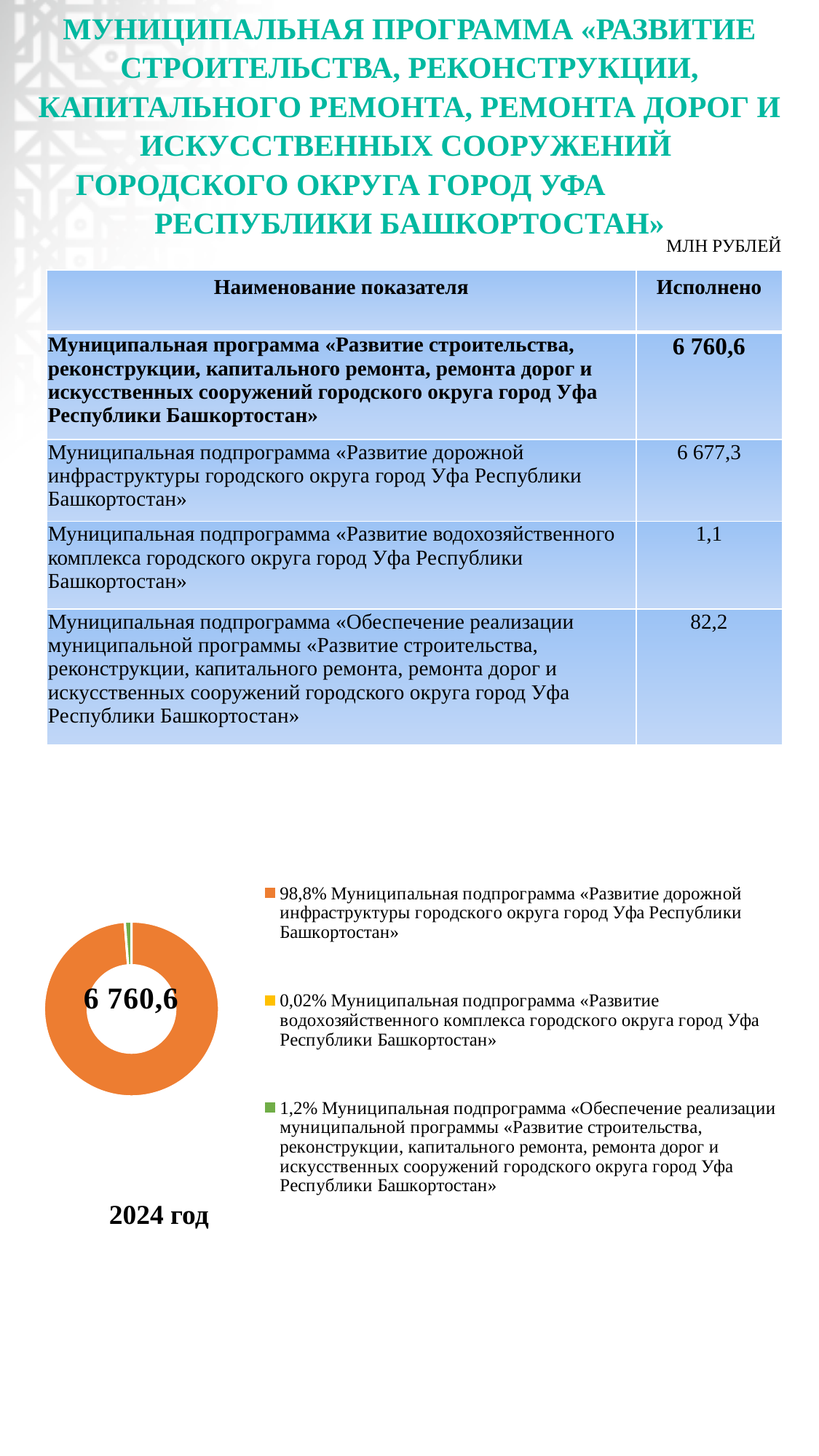
What share of the doughnut chart does the subprogram «Обеспечение реализации муниципальной программы ...» take? 1,2% Which slice is larger in the doughnut chart: «Обеспечение реализации муниципальной программы» or «Развитие водохозяйственного комплекса»? «Обеспечение реализации муниципальной программы» What colour is the largest slice of the doughnut chart? Orange What share of the doughnut chart does the subprogram «Развитие дорожной инфраструктуры городского округа город Уфа Республики Башкортостан» take? 98,8% What year is labelled under the doughnut chart? 2024 год How many entries does the legend of the doughnut chart list? 3 Which subprogram has the smallest slice in the doughnut chart? Муниципальная подпрограмма «Развитие водохозяйственного комплекса городского округа город Уфа Республики Башкортостан» What kind of chart is shown at the bottom of the slide? Doughnut (pie) chart Which subprogram has the largest slice in the doughnut chart? Муниципальная подпрограмма «Развитие дорожной инфраструктуры городского округа город Уфа Республики Башкортостан» What share of the doughnut chart does the subprogram «Развитие водохозяйственного комплекса городского округа город Уфа Республики Башкортостан» take? 0,02% How many slices does the doughnut chart have? 3 What value is printed in the centre of the doughnut chart? 6 760,6